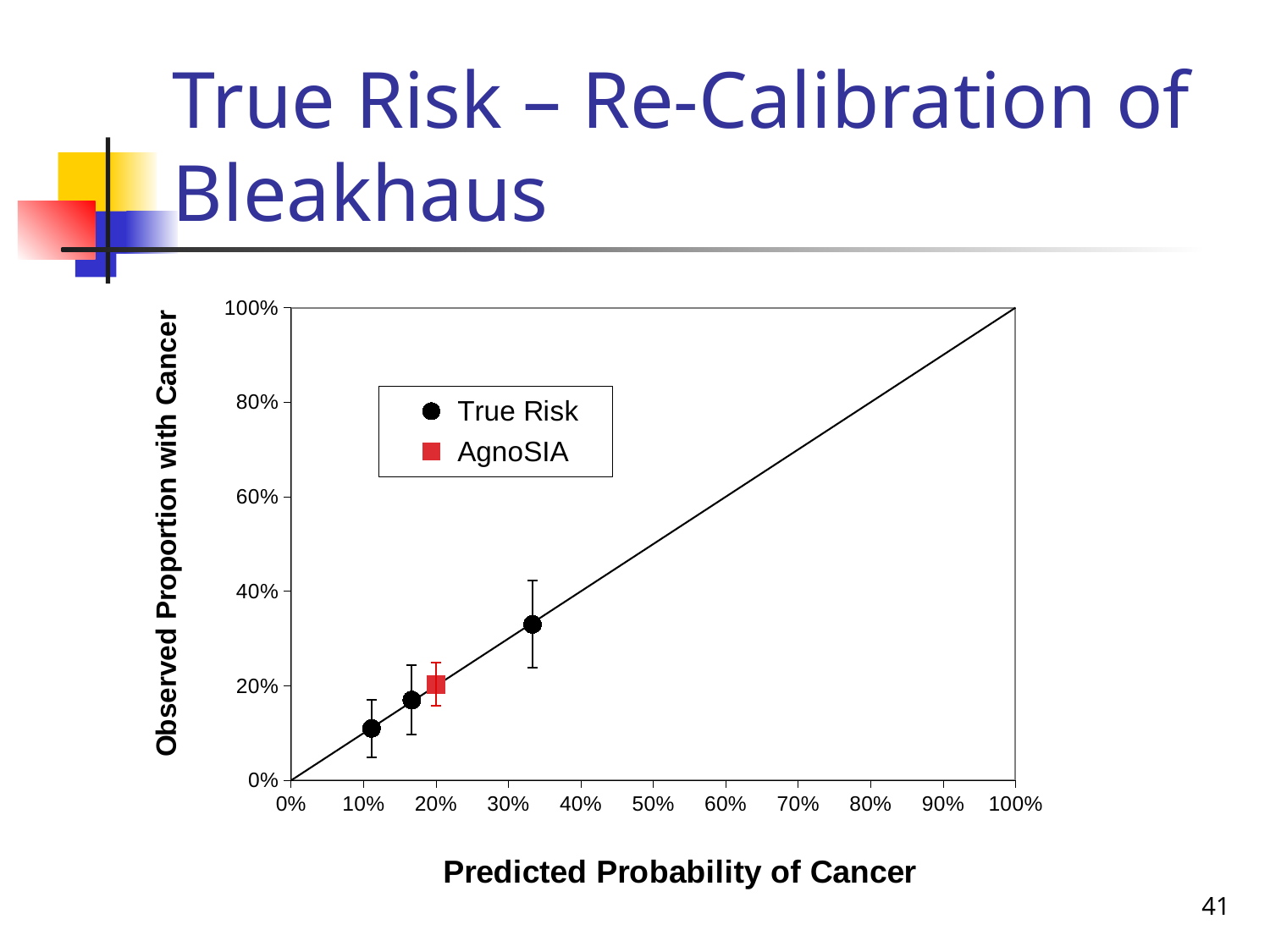
What kind of chart is shown on the slide? scatter plot What colour marker represents the AgnoSIA series in the legend? red square Which series has the point with the highest observed proportion with cancer? True Risk Is the predicted probability of cancer for the AgnoSIA point greater or less than 50%? less Is the observed proportion with cancer for the rightmost True Risk point greater or less than 20%? greater How many AgnoSIA data points are plotted? 1 Is the predicted probability of cancer for the rightmost True Risk point greater or less than 50%? less As predicted probability of cancer increases along the x axis, does the observed proportion with cancer rise or fall? rise How many series does the legend list? 2 How many True Risk data points are plotted? 3 What is the title of the x axis? Predicted Probability of Cancer